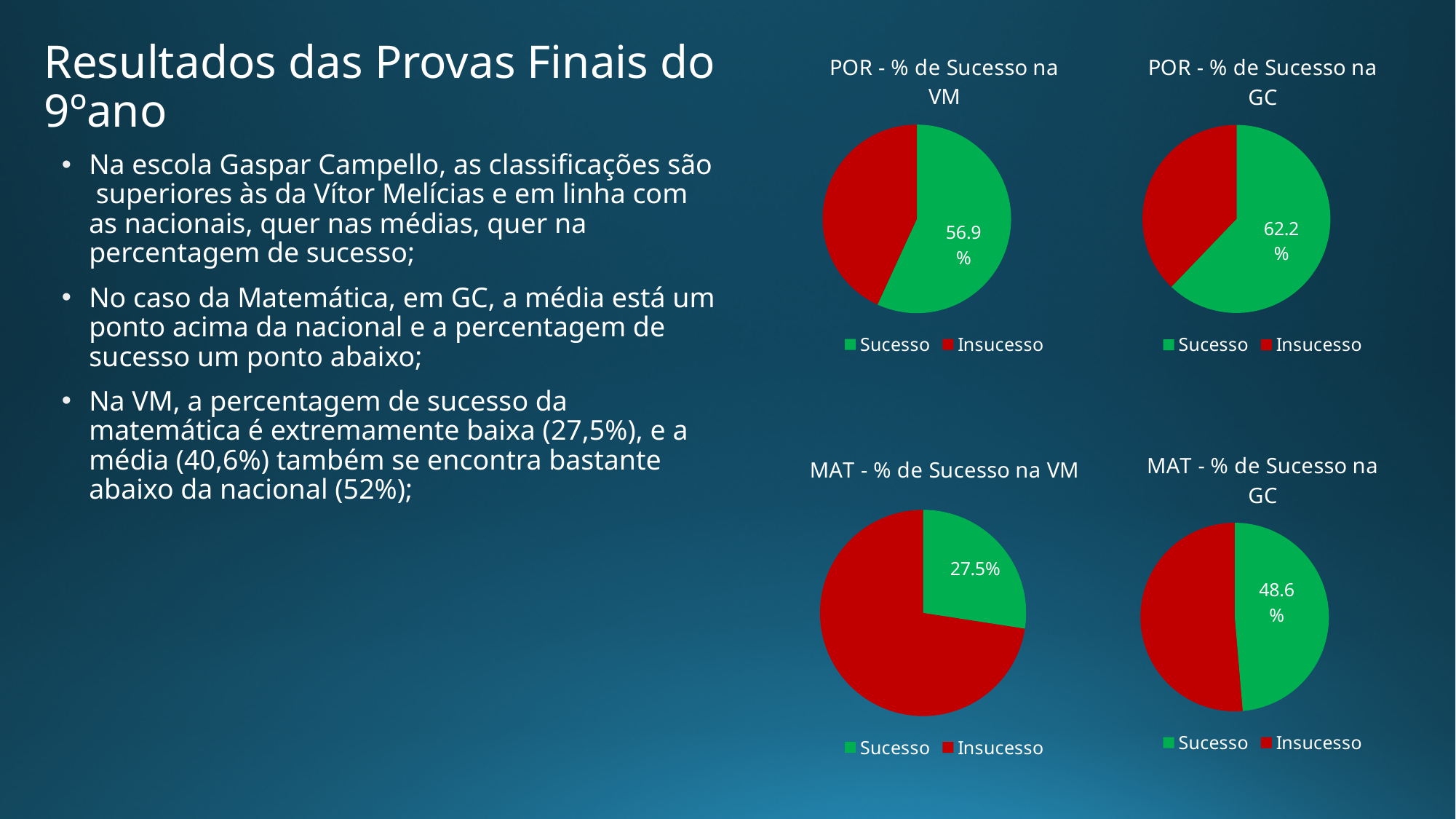
In the chart titled "MAT - % de Sucesso na GC", what colour is the Insucesso slice? red How many entries does the legend of the chart titled "MAT - % de Sucesso na GC" list? 2 What kind of chart is "MAT - % de Sucesso na VM"? pie chart Which is larger: the Sucesso share in "POR - % de Sucesso na VM" or the Sucesso share in "POR - % de Sucesso na GC"? POR - % de Sucesso na GC In the chart titled "POR - % de Sucesso na GC", which slice is larger, Sucesso or Insucesso? Sucesso How many slices does the chart titled "POR - % de Sucesso na VM" have? 2 How many pie charts are shown on the slide? 4 In the chart titled "POR - % de Sucesso na GC", what percentage is shown for the Sucesso slice? 62.2% In the chart titled "MAT - % de Sucesso na GC", what percentage is shown for the Sucesso slice? 48.6% In the chart titled "MAT - % de Sucesso na VM", which slice is larger, Sucesso or Insucesso? Insucesso In the chart titled "POR - % de Sucesso na VM", what percentage is shown for the Sucesso slice? 56.9% In the chart titled "MAT - % de Sucesso na VM", what percentage is shown for the Sucesso slice? 27.5%